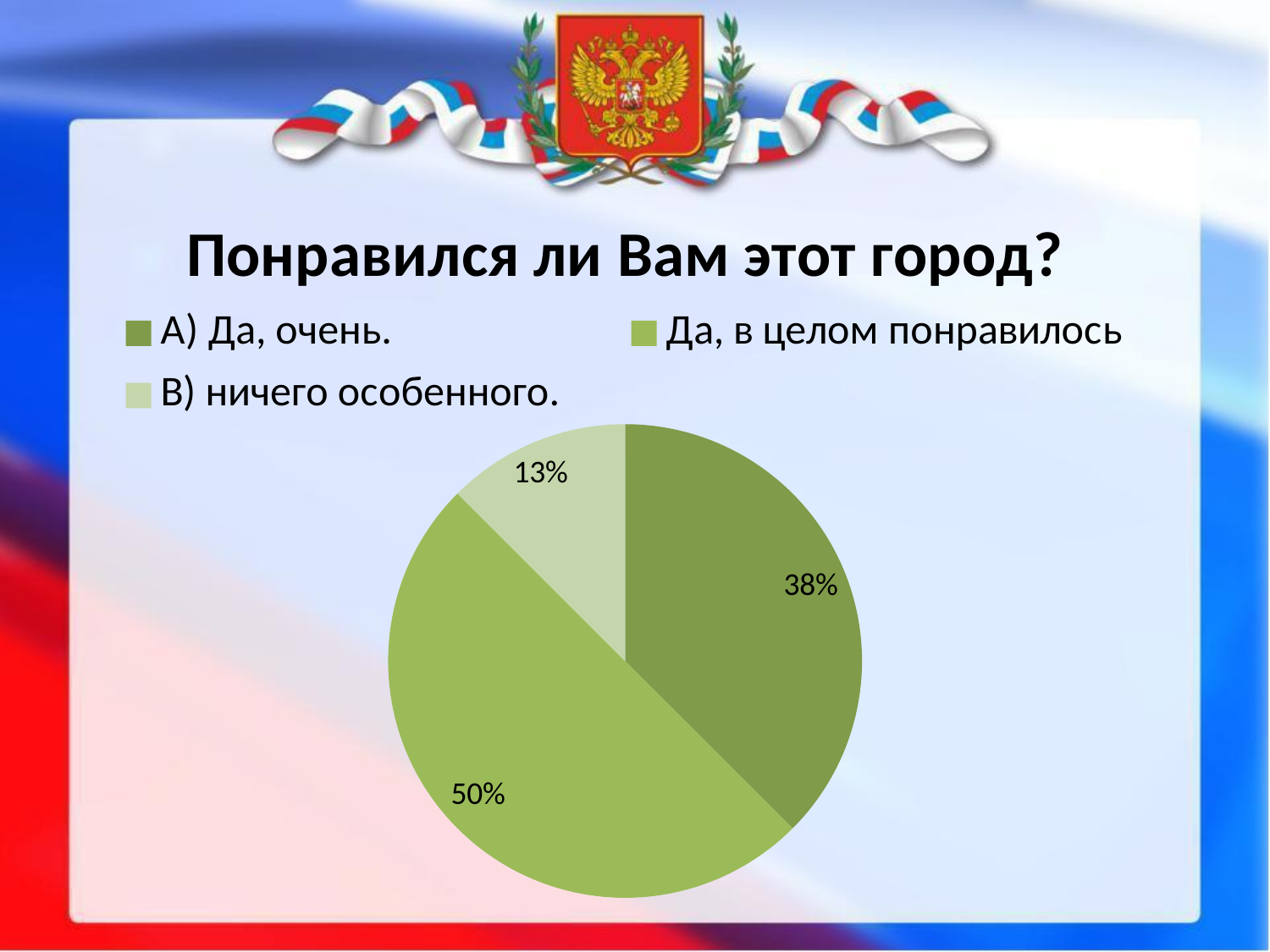
How many slices does the pie chart have? 3 Which legend entry is shown in the lightest green colour? В) ничего особенного. Which is larger: the slice for "А) Да, очень." or the slice for "В) ничего особенного."? А) Да, очень. What share of the pie is labelled for "В) ничего особенного."? 13% What is the title of the chart? Понравился ли Вам этот город? What share of the pie is labelled for "Да, в целом понравилось"? 50% Which category has the largest slice of the pie? Да, в целом понравилось What share of the pie is labelled for "А) Да, очень."? 38% What is the difference in percentage points between "Да, в целом понравилось" and "А) Да, очень."? 12 Which category has the smallest slice of the pie? В) ничего особенного. What kind of chart is shown on the slide? Pie chart How many entries does the legend list? 3